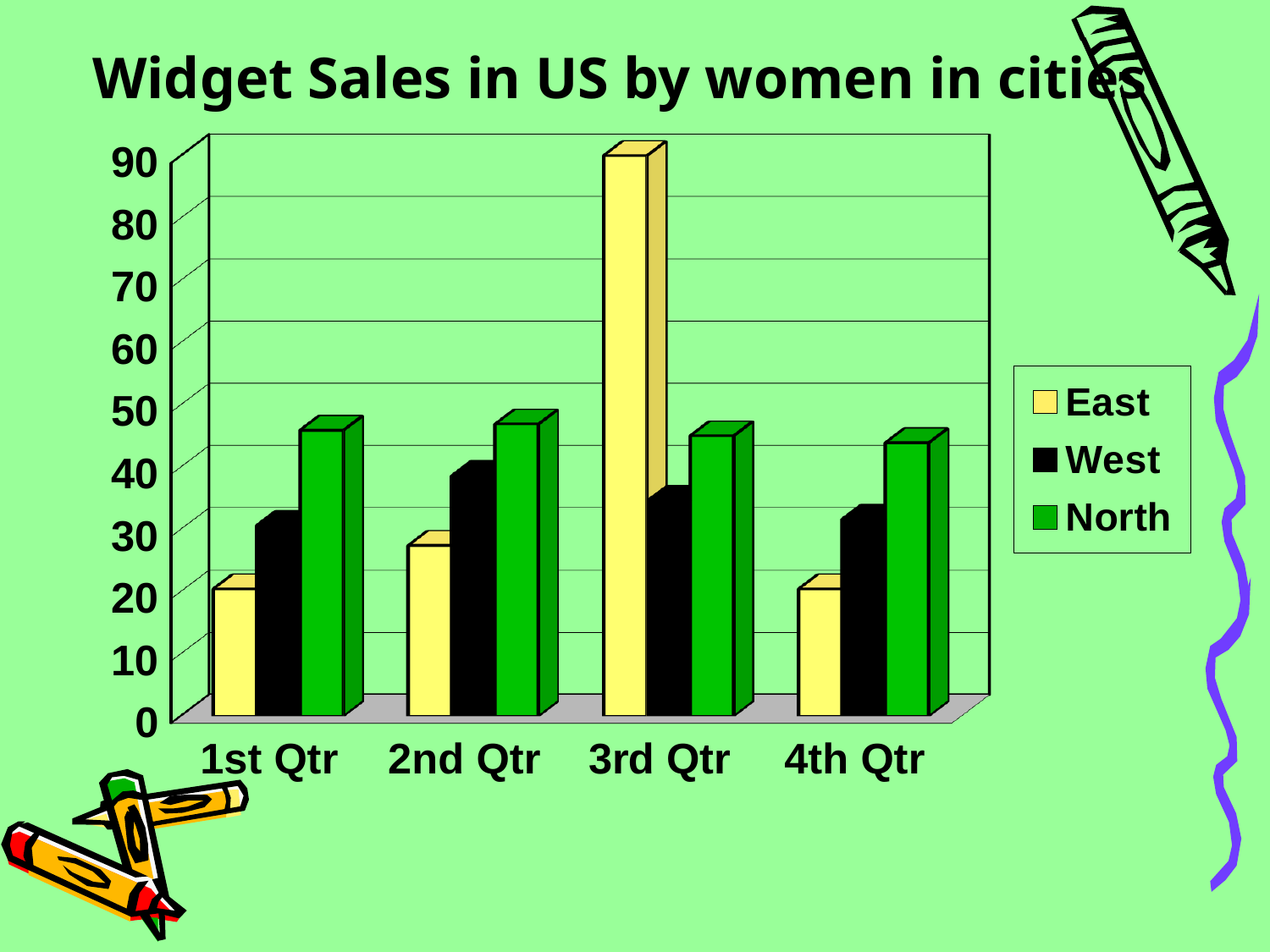
Is the value for North in 1st Qtr greater or less than 50? less How many series does the chart's legend list? 3 How many quarters are shown on the x axis of the chart? 4 What is the title of the chart? Widget Sales in US by women in cities What are the series names listed in the chart's legend? East, West, North Is the value for East in 3rd Qtr greater or less than 80? greater Is the value for East in 1st Qtr greater or less than 30? less In which quarter is the East series highest? 3rd Qtr In 1st Qtr, which is larger, East or North? North What kind of chart is shown on the slide? bar chart In 3rd Qtr, which is larger, East or North? East